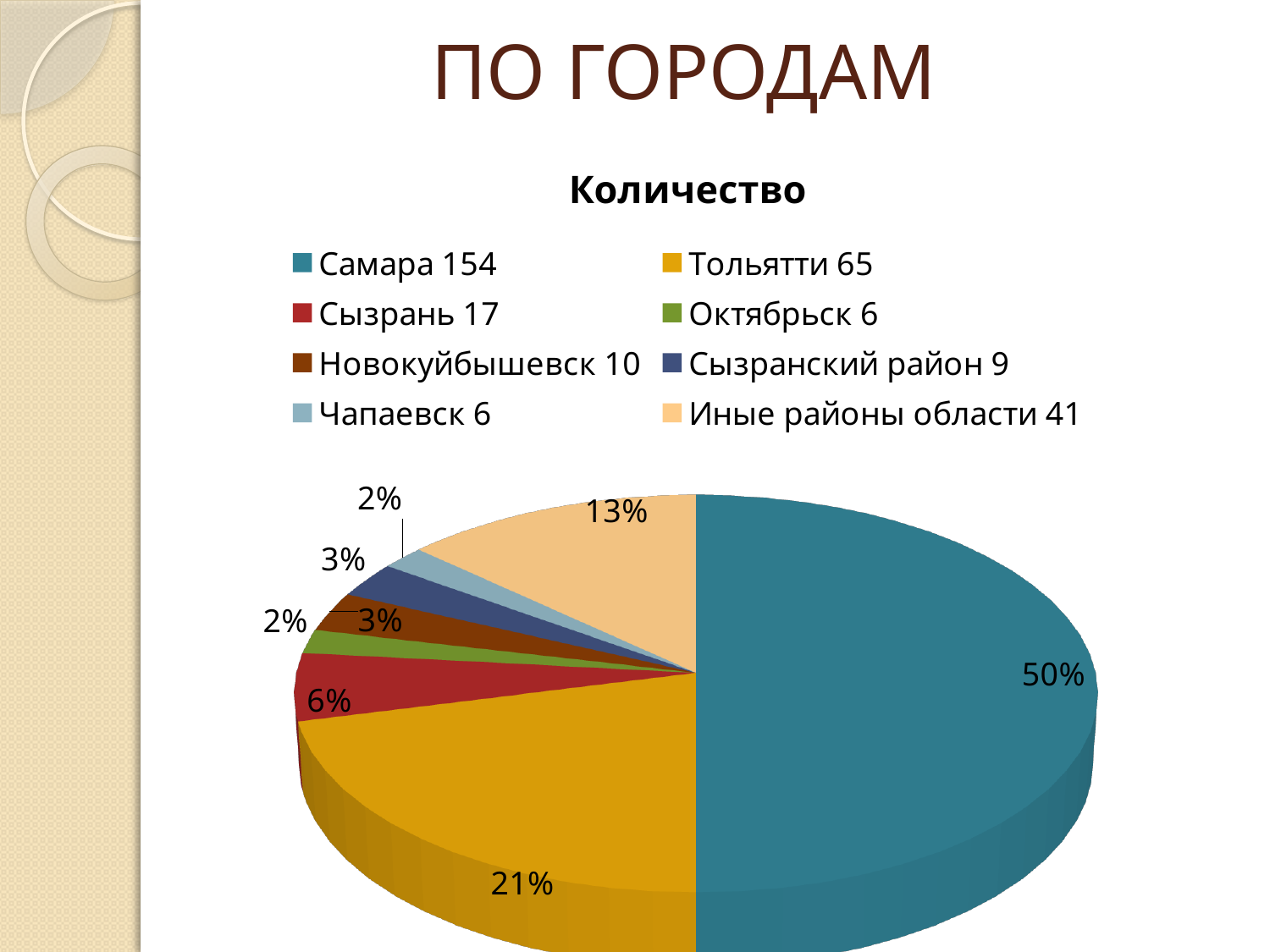
Which category has the largest value? Самара What is the value for Самара? 154 What is the value for Тольятти? 65 How many categories does the pie chart have? 8 What share of the pie does Тольятти represent? 21% What is the title of the chart? Количество What is the difference between the values for Самара and Тольятти? 89 What is the value for Иные районы области? 41 What kind of chart is shown on the slide? pie chart What share of the pie does Самара represent? 50% What is the value for Новокуйбышевск? 10 Which is larger, the value for Тольятти or the value for Иные районы области? Тольятти